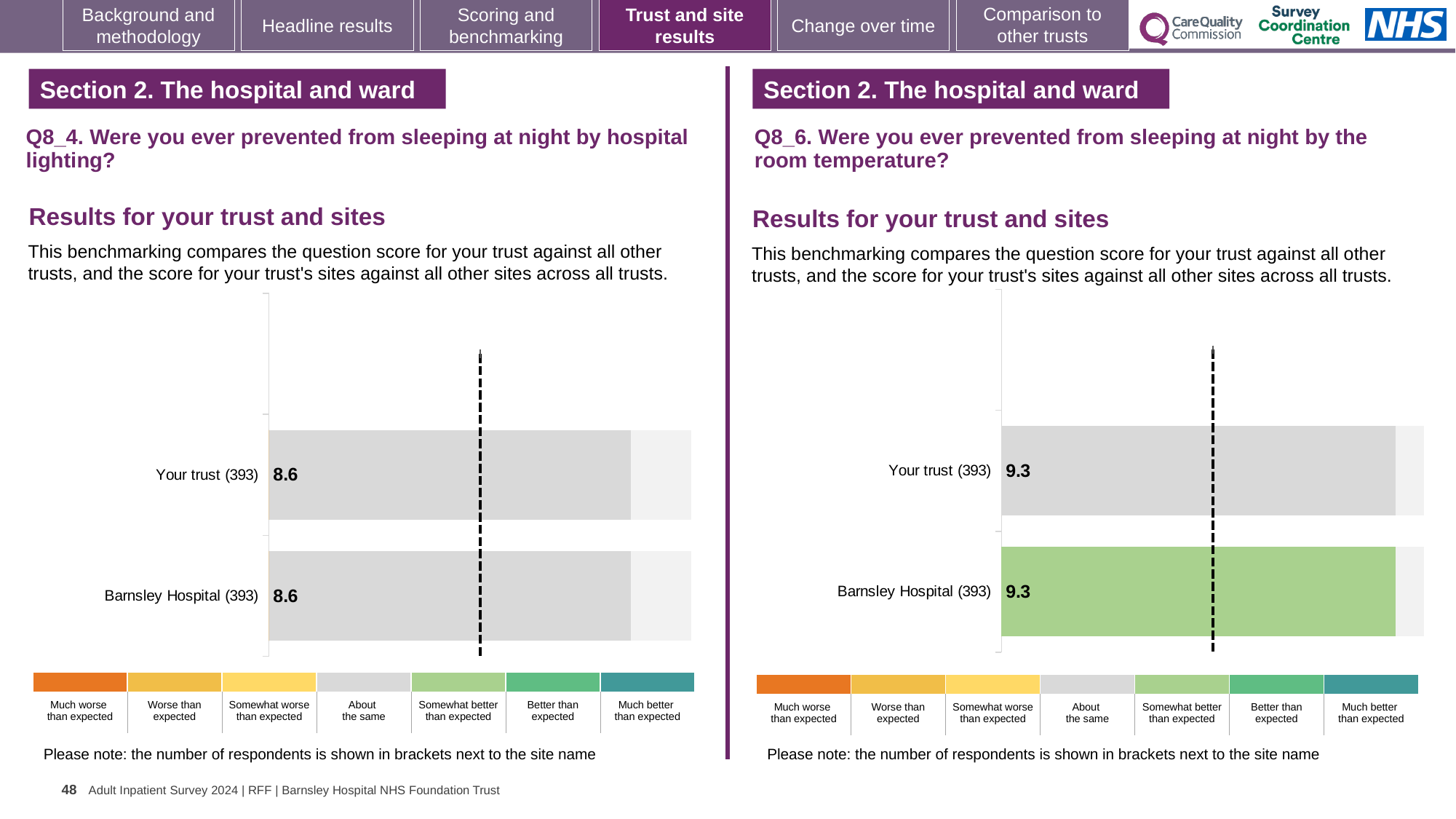
In the Q8_6 chart on the right, which benchmark category does the green colour of the Barnsley Hospital bar correspond to in the legend? Somewhat better than expected How many bars are plotted in the Q8_4 chart on the left? 2 In the Q8_6 chart on the right, what is the score for Barnsley Hospital? 9.3 In the Q8_6 chart on the right, what is the score for Your trust? 9.3 How many categories does the colour legend below the Q8_4 chart on the left list? 7 In the Q8_4 chart on the left, what is the score for Your trust? 8.6 What kind of chart is used for the Q8_6 results on the right? Bar chart What is the difference between the Your trust score in the Q8_6 chart on the right and the Your trust score in the Q8_4 chart on the left? 0.7 In the Q8_4 chart on the left, what is the score for Barnsley Hospital? 8.6 In the Q8_4 chart on the left, how many respondents are shown in brackets next to Barnsley Hospital? 393 How many bars are plotted in the Q8_6 chart on the right? 2 Which is larger: the Barnsley Hospital score in the Q8_6 chart on the right or the Barnsley Hospital score in the Q8_4 chart on the left? Q8_6 (9.3)